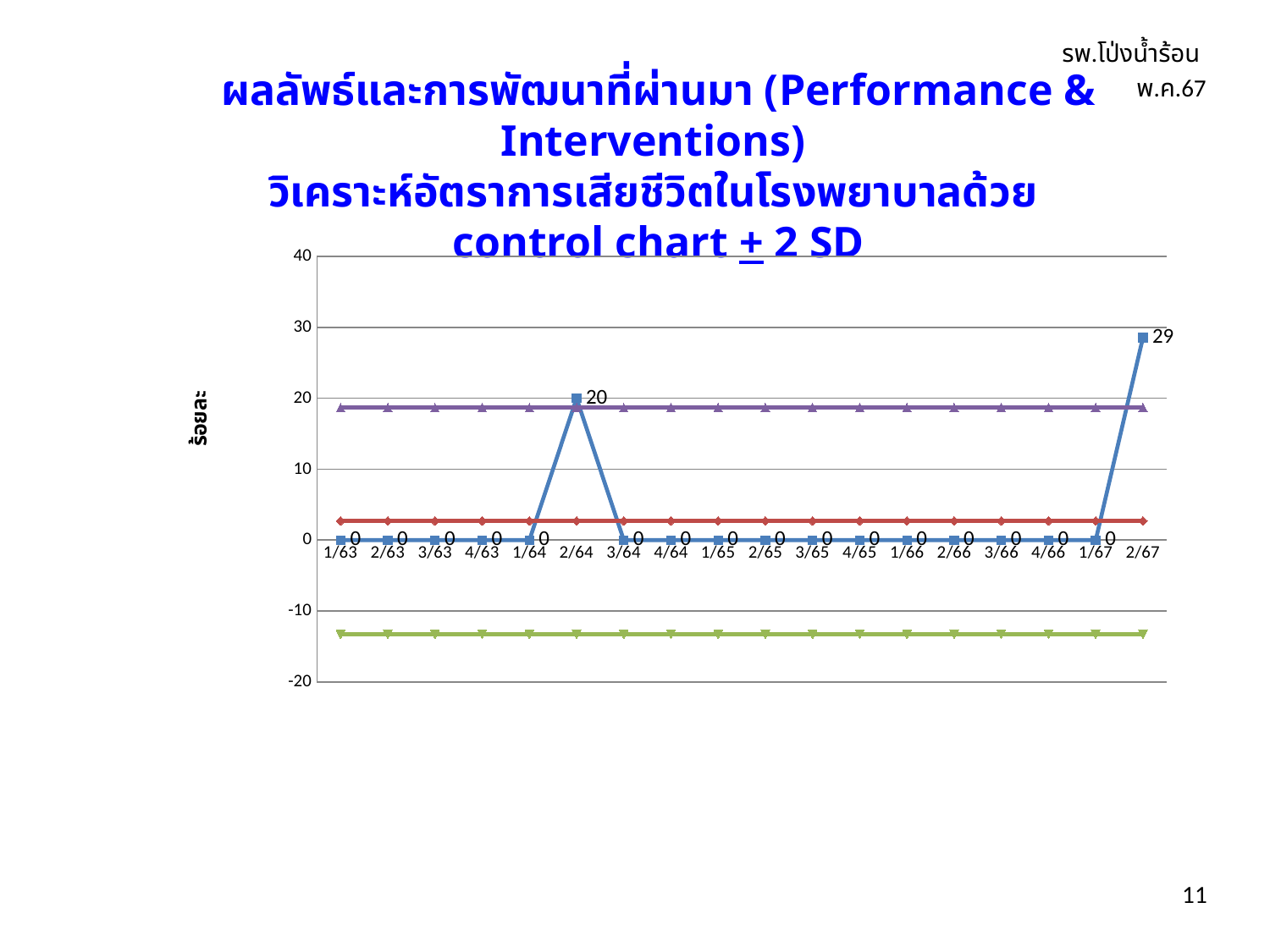
What is the highest tick value shown on the y axis? 40 How many periods are shown on the x axis? 18 What type of chart is shown on the slide? line chart Is the value of the lower control limit line (green) greater or less than -10? less What is the value plotted for 1/65 on the data line? 0 What is the difference between the values for 2/67 and 2/64? 9 Is the value of the upper control limit line (purple) greater or less than 10? greater What is the value plotted for 2/64 on the data line? 20 Which period has the highest value on the data line? 2/67 Which is larger, the value for 2/64 or the value for 2/67? 2/67 What is the label on the y axis? ร้อยละ What is the value plotted for 2/67 on the data line? 29